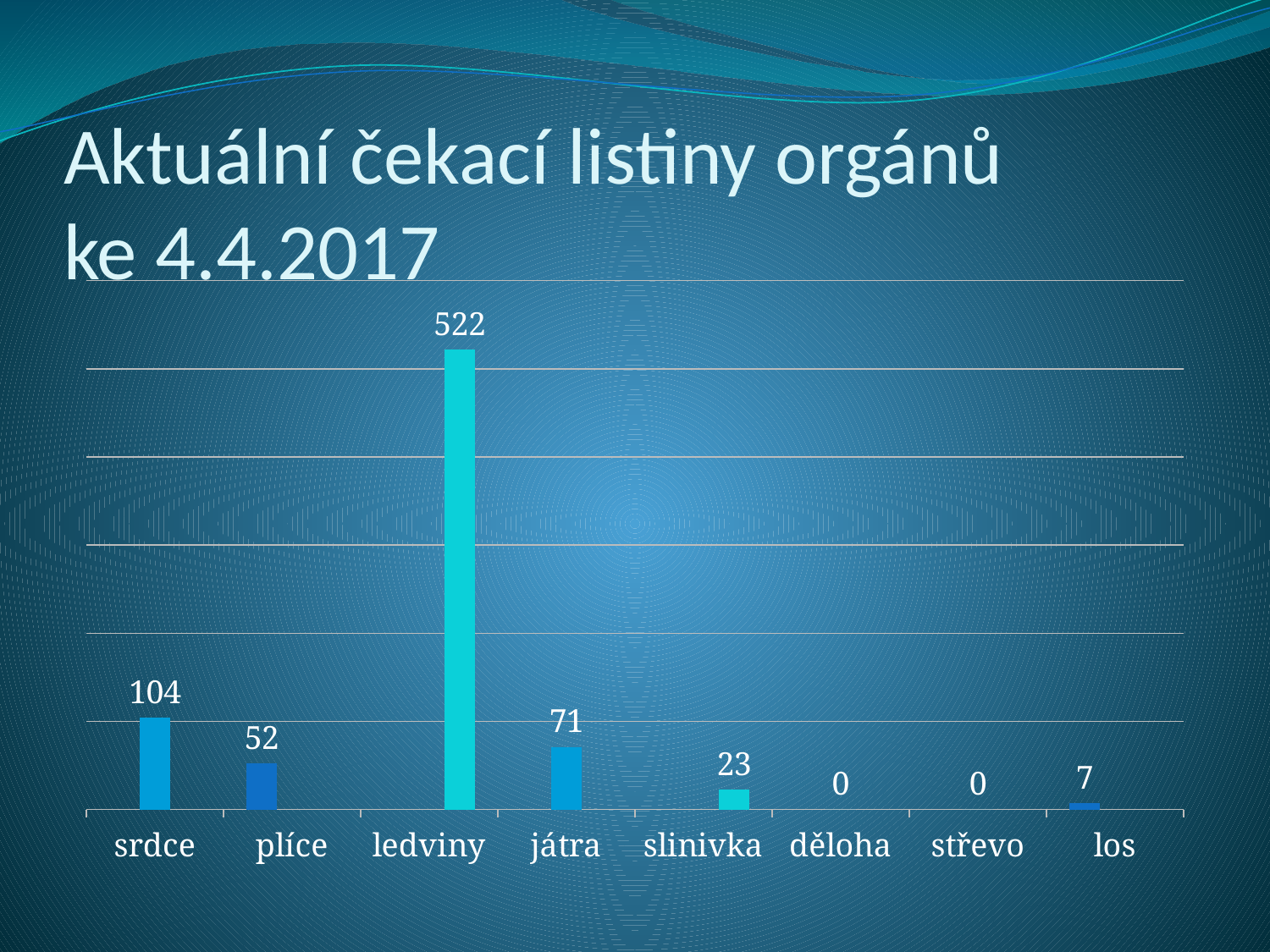
How many categories are shown on the x axis? 8 What is the difference between the values for ledviny and játra? 451 Which is larger, the value for játra or the value for plíce? játra Which categories have a value of 0? děloha and střevo Which category has the highest value? ledviny What is the title of the slide? Aktuální čekací listiny orgánů ke 4.4.2017 What is the value for slinivka? 23 What kind of chart is shown on the slide? bar chart What is the difference between the values for srdce and plíce? 52 What is the value for ledviny? 522 What is the value for los? 7 What is the value for srdce? 104